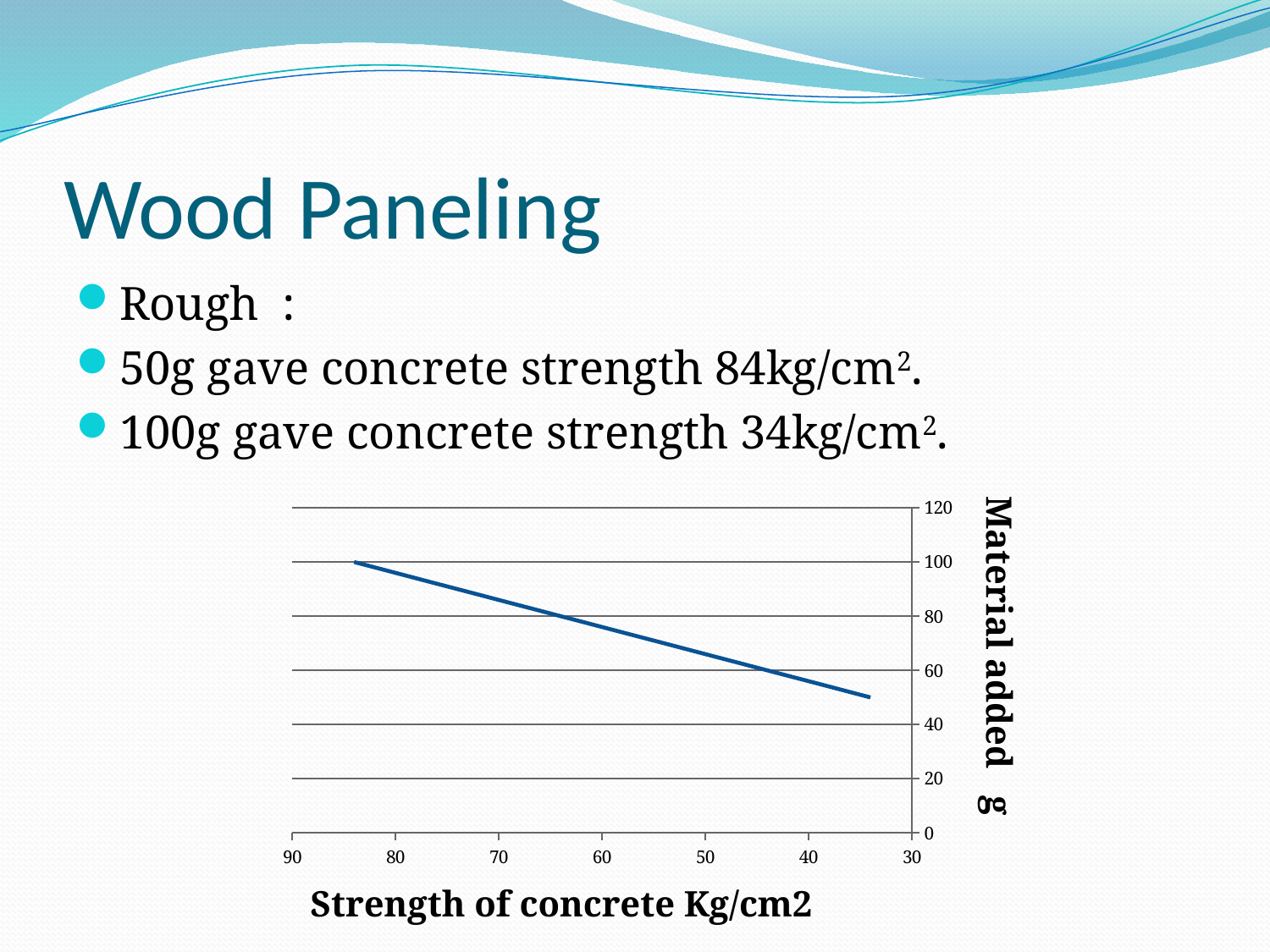
What is the title of the vertical axis of the chart? Material added g How much material was added when the concrete strength was 34 Kg/cm2? 50 Does the line fall or rise from left to right across the chart? falls Is the material added at a concrete strength of 50 Kg/cm2 greater or less than 60? greater How much material was added when the concrete strength was 84 Kg/cm2? 100 Is the material added at a concrete strength of 70 Kg/cm2 greater or less than 80? greater What is the difference in material added between the two ends of the line (100 g and 50 g)? 50 What kind of chart is shown on the slide? line chart Which has more material added: the point at concrete strength 84 Kg/cm2 or the point at 34 Kg/cm2? 84 Kg/cm2 What is the lowest value of material added reached by the line? 50 What is the title of the horizontal axis of the chart? Strength of concrete Kg/cm2 What is the highest value of material added reached by the line? 100